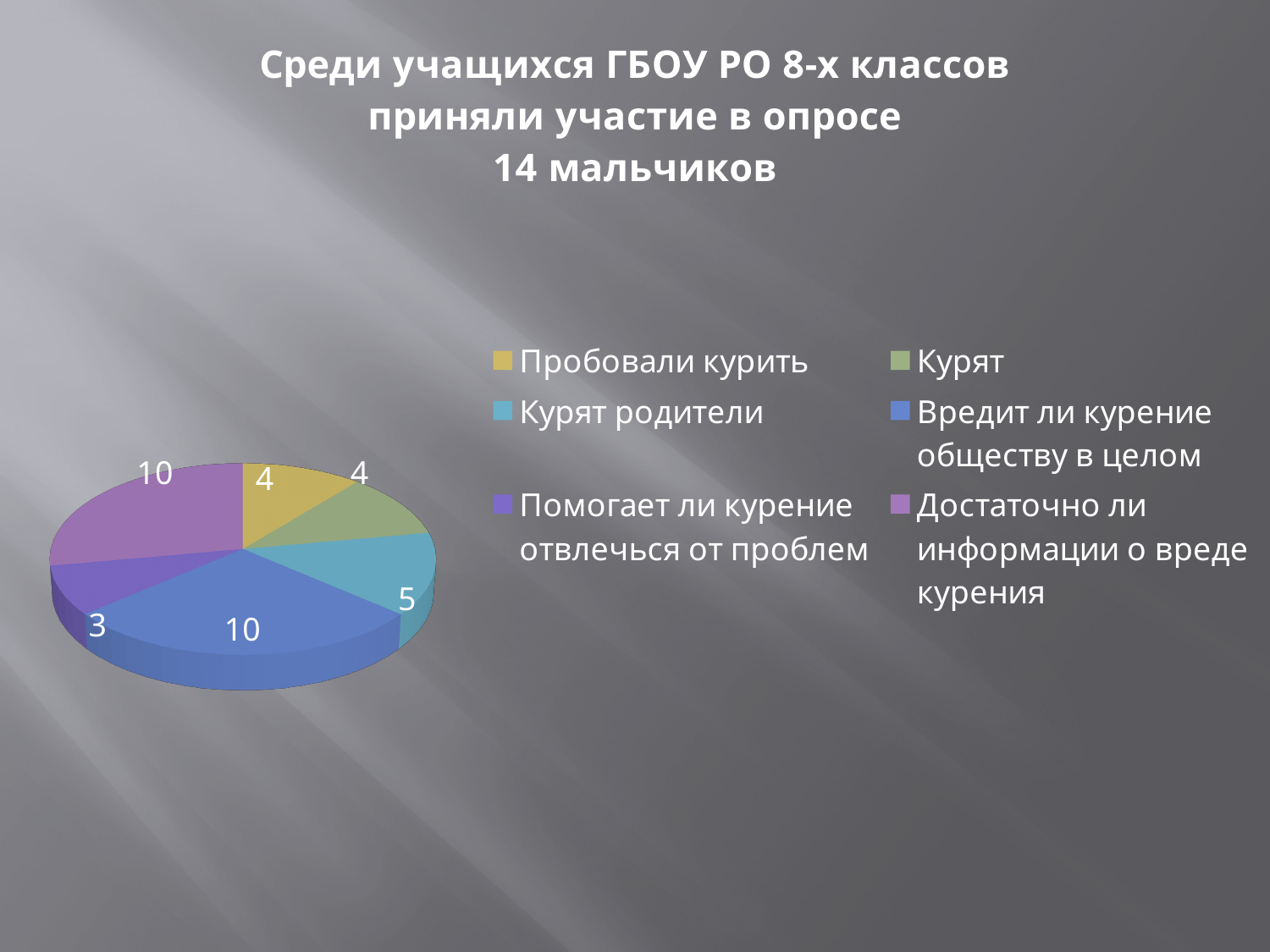
What is the value for "Курят родители"? 5 What is the difference between the value for "Курят родители" and the value for "Курят"? 1 What colour is the slice for "Достаточно ли информации о вреде курения"? purple Which category has the smallest slice? Помогает ли курение отвлечься от проблем What kind of chart is shown on the slide? pie chart What is the value for "Помогает ли курение отвлечься от проблем"? 3 How many slices does the pie chart have? 6 What is the value for "Вредит ли курение обществу в целом"? 10 How many entries does the legend list? 6 What is the difference between the value for "Достаточно ли информации о вреде курения" and the value for "Помогает ли курение отвлечься от проблем"? 7 Which is larger, the value for "Курят родители" or the value for "Курят"? Курят родители What is the value for "Пробовали курить"? 4